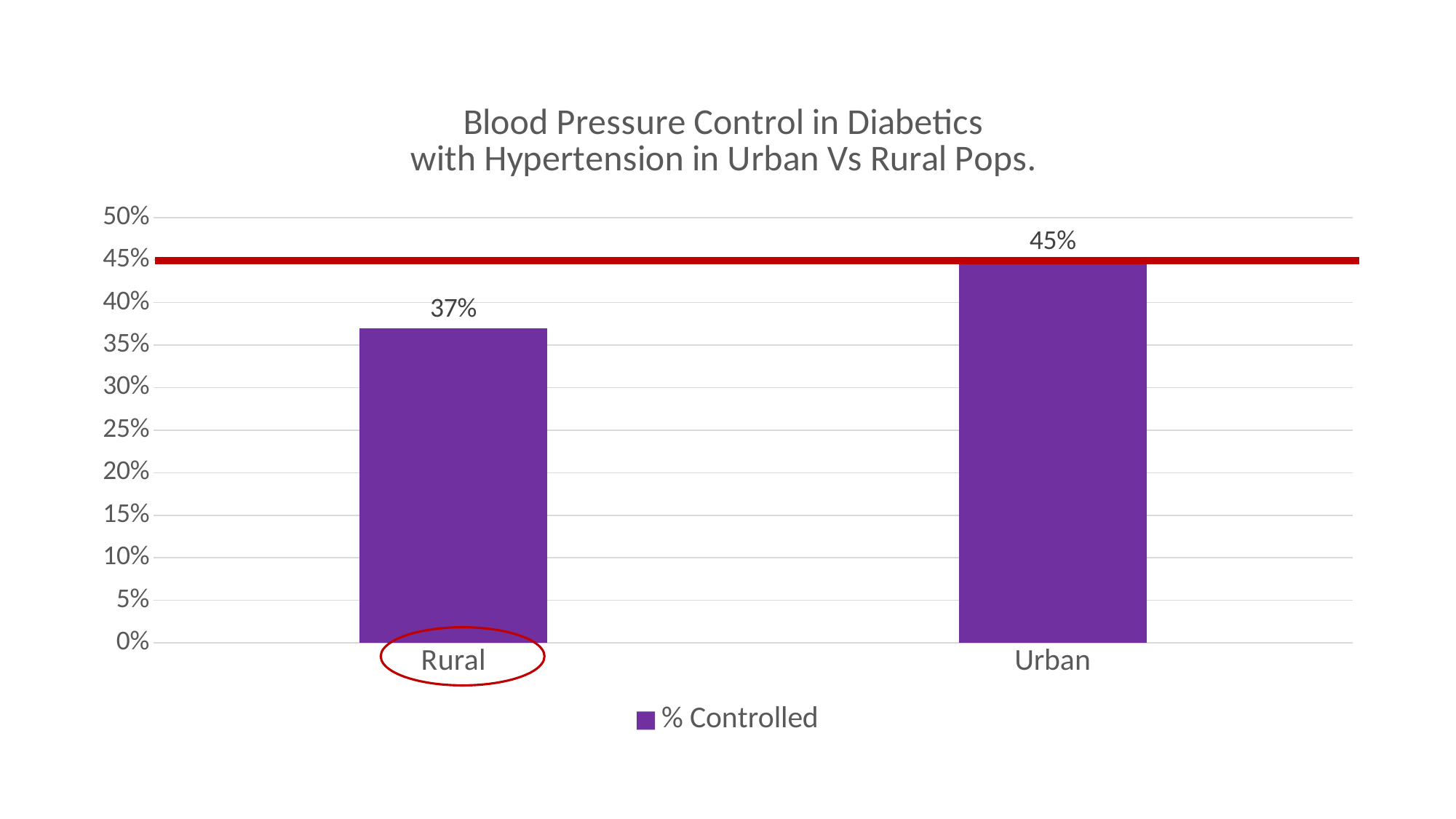
How many categories are shown on the x axis? 2 Which has a larger % Controlled, Rural or Urban? Urban What is the % Controlled value for Rural? 37% Which category has the lowest % Controlled? Rural How many series does the legend list? 1 Is the value for Rural greater or less than 40%? less What is the difference in % Controlled between Urban and Rural? 8% What is the name of the series listed in the legend? % Controlled What is the % Controlled value for Urban? 45% What kind of chart is shown on the slide? bar chart What is the title of the chart? Blood Pressure Control in Diabetics with Hypertension in Urban Vs Rural Pops. Which category has the highest % Controlled? Urban